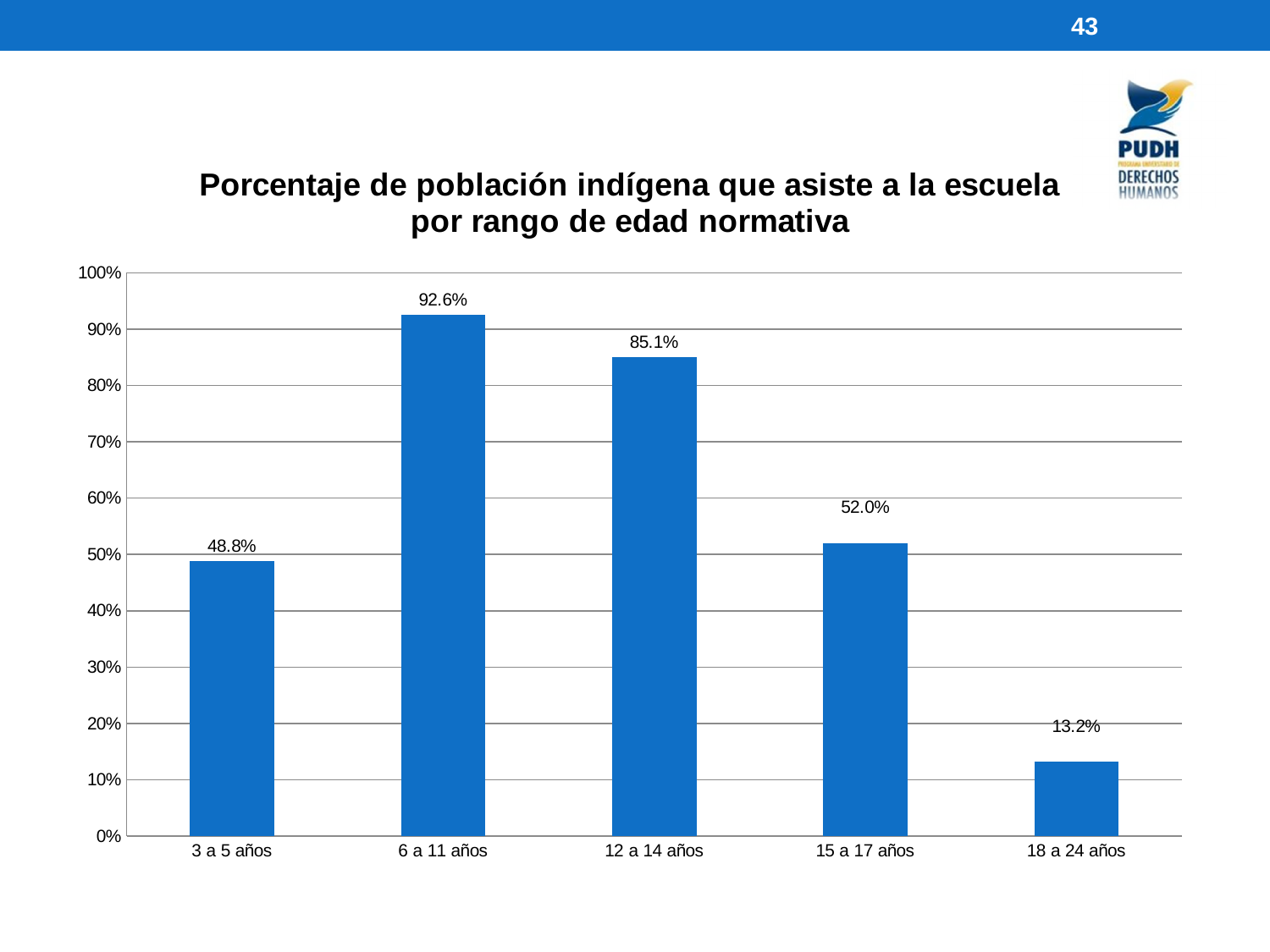
How many age ranges are shown on the chart? 5 What is the difference between the values for 6 a 11 años and 12 a 14 años? 7.5% What is the title of the chart? Porcentaje de población indígena que asiste a la escuela por rango de edad normativa Is the value for 3 a 5 años greater or less than 50%? less Which age range has the highest percentage attending school? 6 a 11 años Which is larger, the value for 3 a 5 años or the value for 15 a 17 años? 15 a 17 años What kind of chart is shown on the slide? bar chart What is the value shown for the 18 a 24 años age range? 13.2% What percentage of the indigenous population aged 6 a 11 años attends school? 92.6% Which age range has the lowest percentage attending school? 18 a 24 años What is the difference between the values for 15 a 17 años and 3 a 5 años? 3.2% What is the value shown for the 15 a 17 años age range? 52.0%